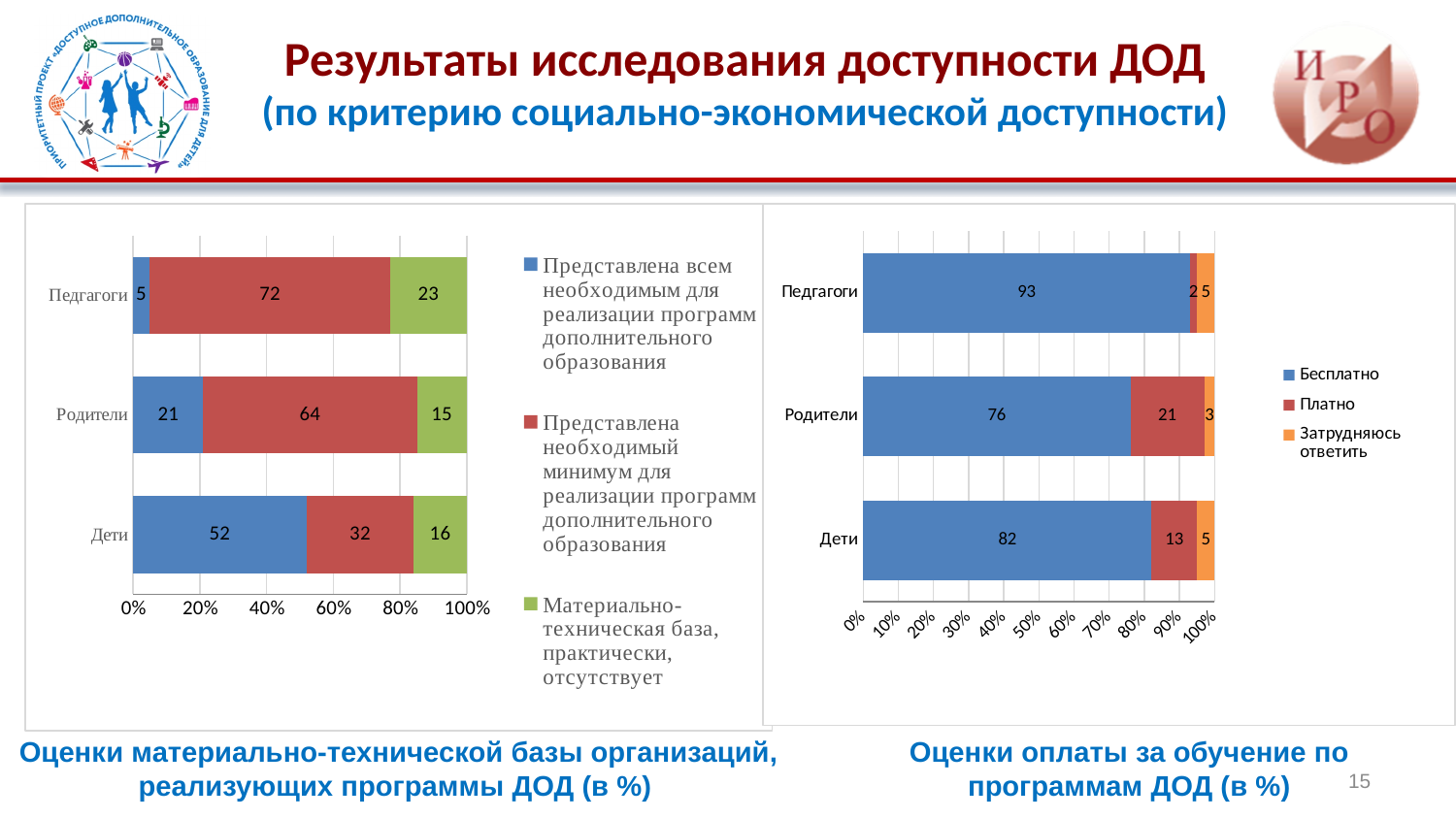
In the left chart (Оценки материально-технической базы организаций), how many series does the legend list? 3 In the right chart (Оценки оплаты за обучение по программам ДОД), what is the value of Платно for Родители? 21 In the right chart (Оценки оплаты за обучение по программам ДОД), which is larger: Платно for Дети or Платно for Родители? Родители How many categories are shown in the left chart (Оценки материально-технической базы организаций)? 3 In the right chart (Оценки оплаты за обучение по программам ДОД), what is the value of Бесплатно for Педагоги? 93 In the left chart (Оценки материально-технической базы организаций), what is the difference between the red series values for Родители and Дети? 32 In the left chart (Оценки материально-технической базы организаций), which category has the highest value for the green series (Материально-техническая база, практически, отсутствует)? Педагоги In the left chart (Оценки материально-технической базы организаций), what is the value of the blue series (Представлена всем необходимым) for Дети? 52 In the right chart (Оценки оплаты за обучение по программам ДОД), what is the difference between Бесплатно for Педагоги and Бесплатно for Дети? 11 What kind of chart is the right chart (Оценки оплаты за обучение по программам ДОД)? Stacked bar chart In the left chart (Оценки материально-технической базы организаций), what is the value of the red series (Представлена необходимый минимум) for Педагоги? 72 In the right chart (Оценки оплаты за обучение по программам ДОД), which category has the lowest value for Бесплатно? Родители